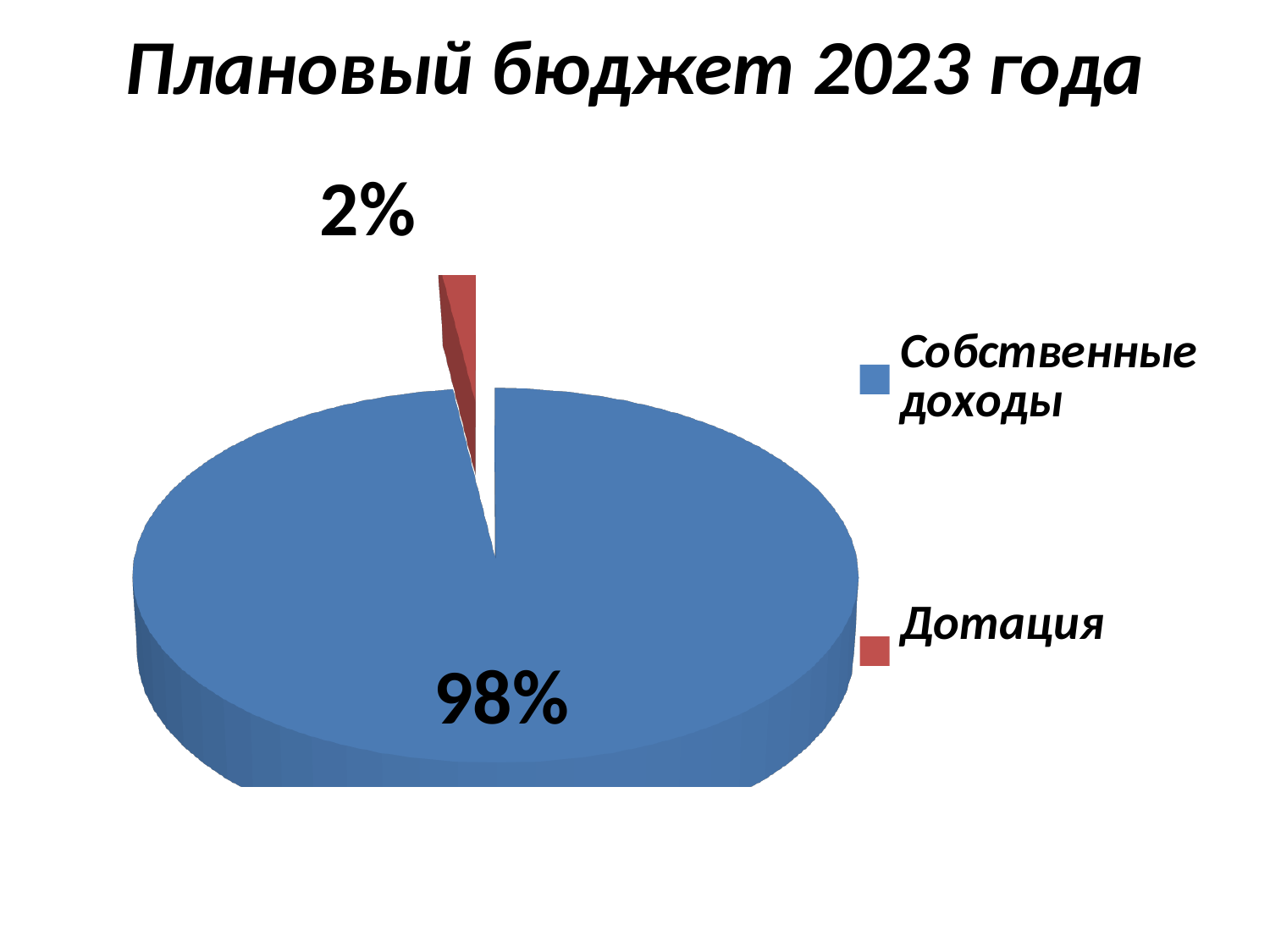
What is the title of the slide? Плановый бюджет 2023 года What share of the pie does Собственные доходы have? 98% What is the difference in percentage points between Собственные доходы and Дотация? 96 Which category has the largest slice of the pie? Собственные доходы Which category has the smallest slice of the pie? Дотация What colour is the Дотация slice? red What share of the pie does Дотация have? 2% Which is larger, Собственные доходы or Дотация? Собственные доходы What kind of chart is shown on the slide? pie chart How many slices does the pie chart have? 2 How many entries does the legend list? 2